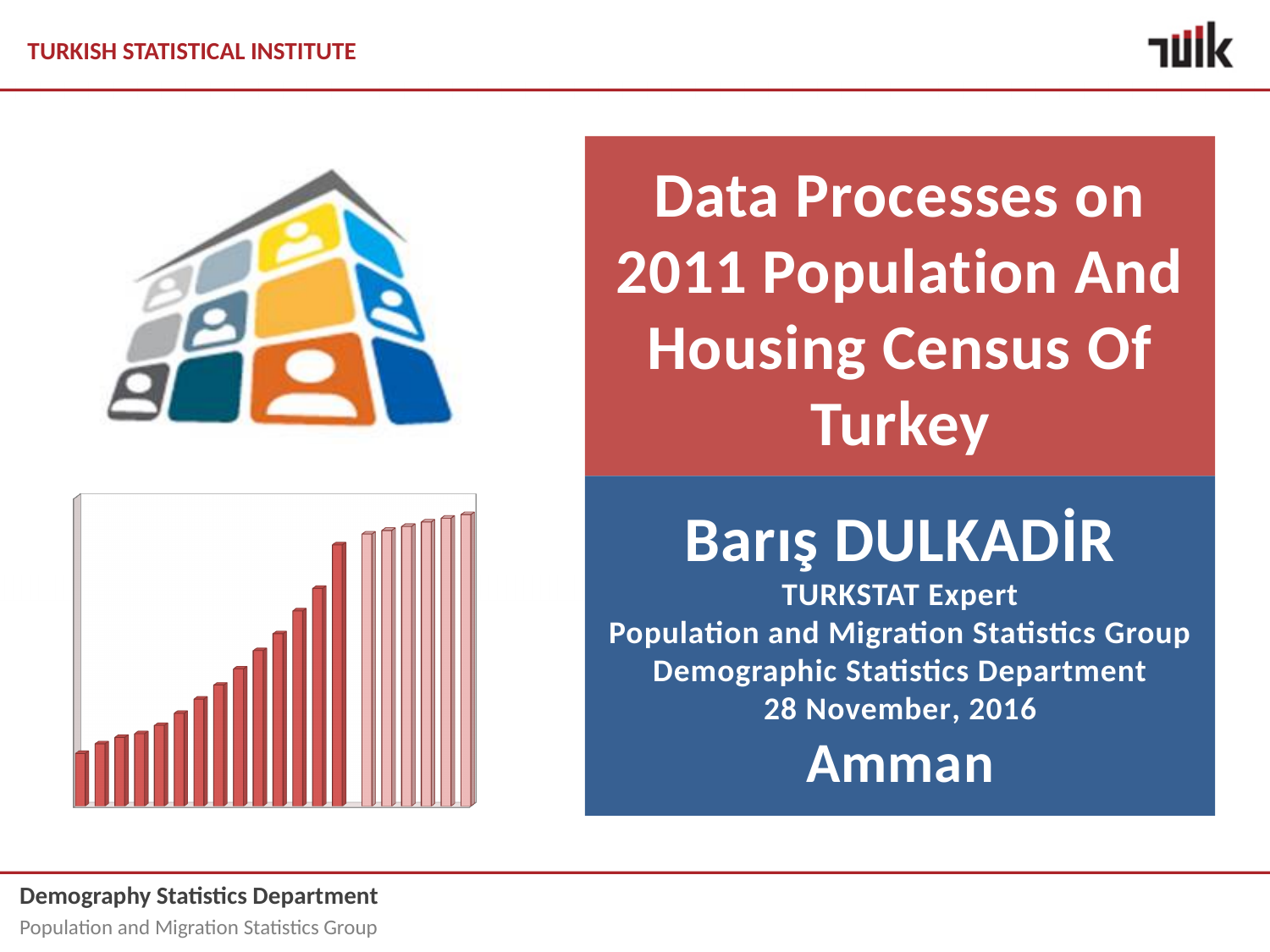
Which bar in the chart on the left is the tallest, the leftmost or the rightmost? rightmost Are the lighter-coloured bars in the chart on the left located on the left or the right side of the chart? right Do the bars in the chart on the left rise or fall from left to right? rise How many different bar colours are used in the chart on the left? 2 What kind of chart is shown on the left side of the slide? bar chart Which bar in the chart on the left is the shortest, the leftmost or the rightmost? leftmost Is the leftmost bar or the rightmost bar taller in the chart on the left? rightmost